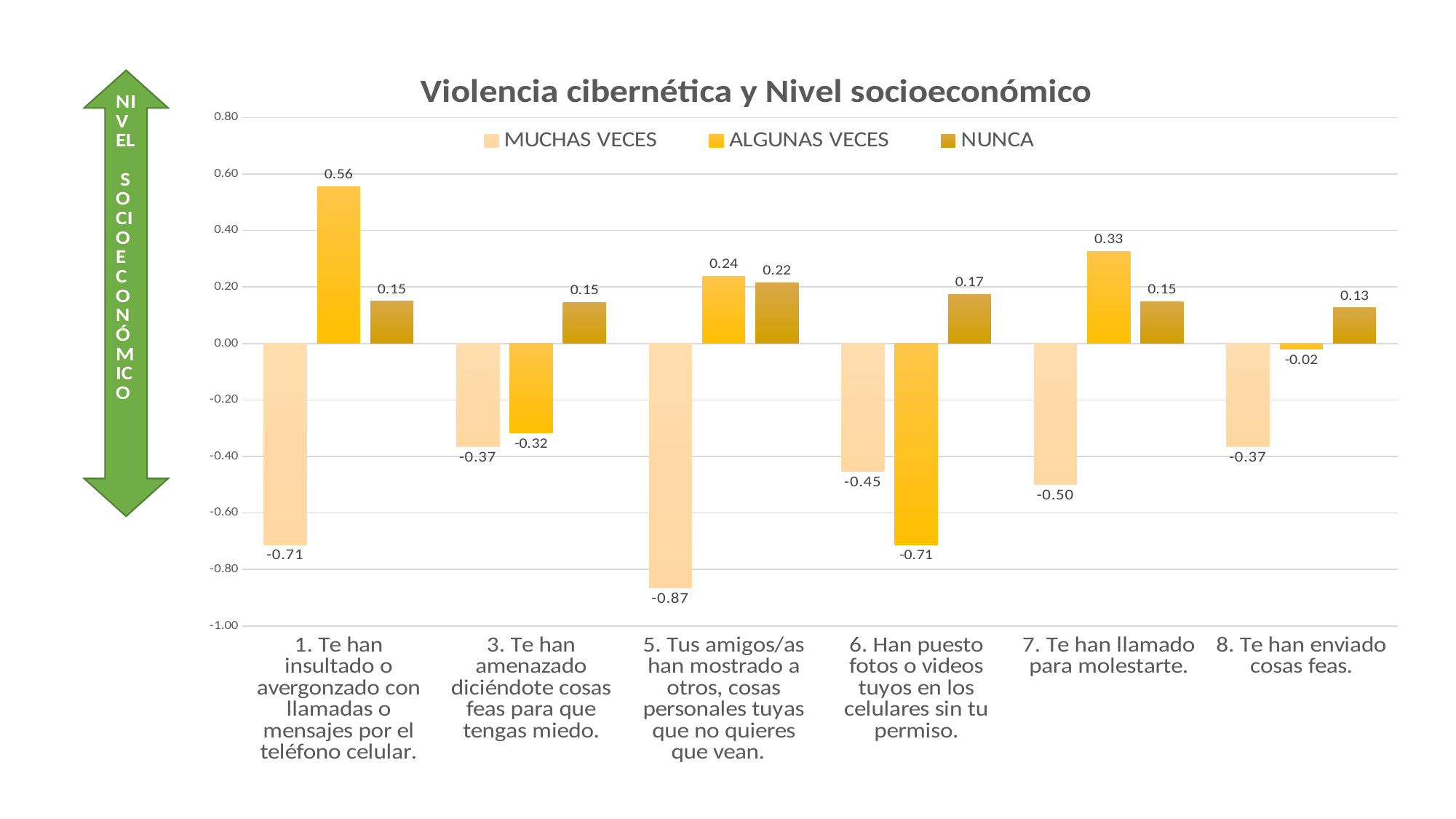
What kind of chart is shown on the slide? Bar chart How many categories are shown on the x axis? 6 Which is larger: the NUNCA value for category 5 or the NUNCA value for category 6? Category 5 (0.22) What is the value of NUNCA for category 8 (Te han enviado cosas feas)? 0.13 What is the value of ALGUNAS VECES for category 6 (Han puesto fotos o videos tuyos en los celulares sin tu permiso)? -0.71 Which category has the highest ALGUNAS VECES value? 1. Te han insultado o avergonzado con llamadas o mensajes por el teléfono celular. How many series does the legend list? 3 What is the difference between the ALGUNAS VECES values for category 1 (0.56) and category 7 (0.33)? 0.23 What is the value of MUCHAS VECES for category 5 (Tus amigos/as han mostrado a otros, cosas personales tuyas que no quieres que vean)? -0.87 What is the title of the chart? Violencia cibernética y Nivel socioeconómico Which category has the lowest MUCHAS VECES value? 5. Tus amigos/as han mostrado a otros, cosas personales tuyas que no quieres que vean. What is the value of ALGUNAS VECES for category 1 (Te han insultado o avergonzado con llamadas o mensajes por el teléfono celular)? 0.56